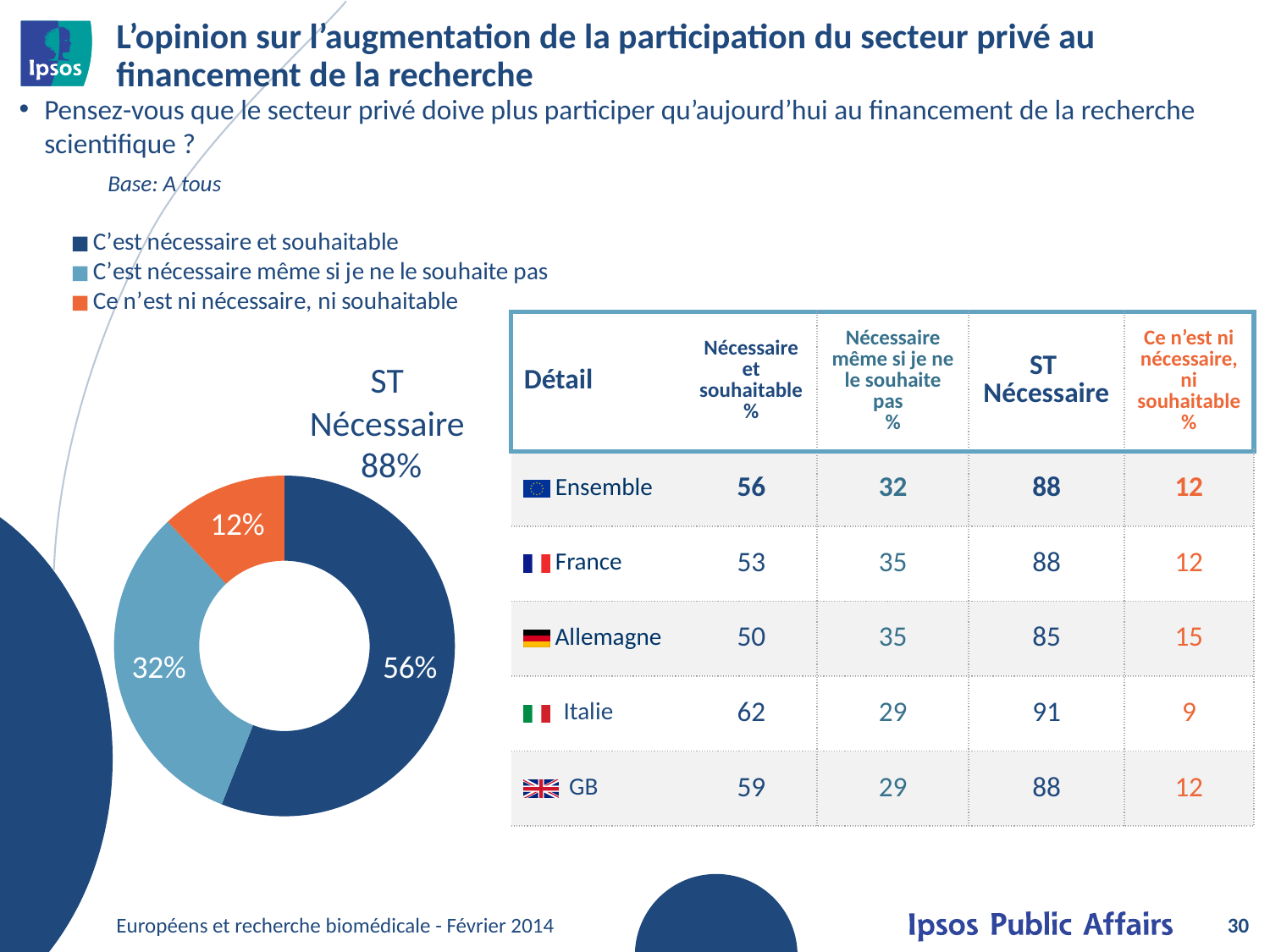
What colour is the "Ce n'est ni nécessaire, ni souhaitable" slice in the donut chart? Orange What percentage of the donut chart corresponds to "C'est nécessaire et souhaitable"? 56% What is the difference in percentage points between the "C'est nécessaire et souhaitable" slice and the "C'est nécessaire même si je ne le souhaite pas" slice? 24 What is the "ST Nécessaire" percentage shown above the donut chart? 88% Which slice is larger: "C'est nécessaire même si je ne le souhaite pas" or "Ce n'est ni nécessaire, ni souhaitable"? C'est nécessaire même si je ne le souhaite pas What kind of chart is shown on the slide? Donut chart Which response has the largest slice in the donut chart? C'est nécessaire et souhaitable What percentage of the donut chart corresponds to "C'est nécessaire même si je ne le souhaite pas"? 32% How many entries does the legend list? 3 How many slices does the donut chart have? 3 Which response has the smallest slice in the donut chart? Ce n'est ni nécessaire, ni souhaitable What percentage of the donut chart corresponds to "Ce n'est ni nécessaire, ni souhaitable"? 12%